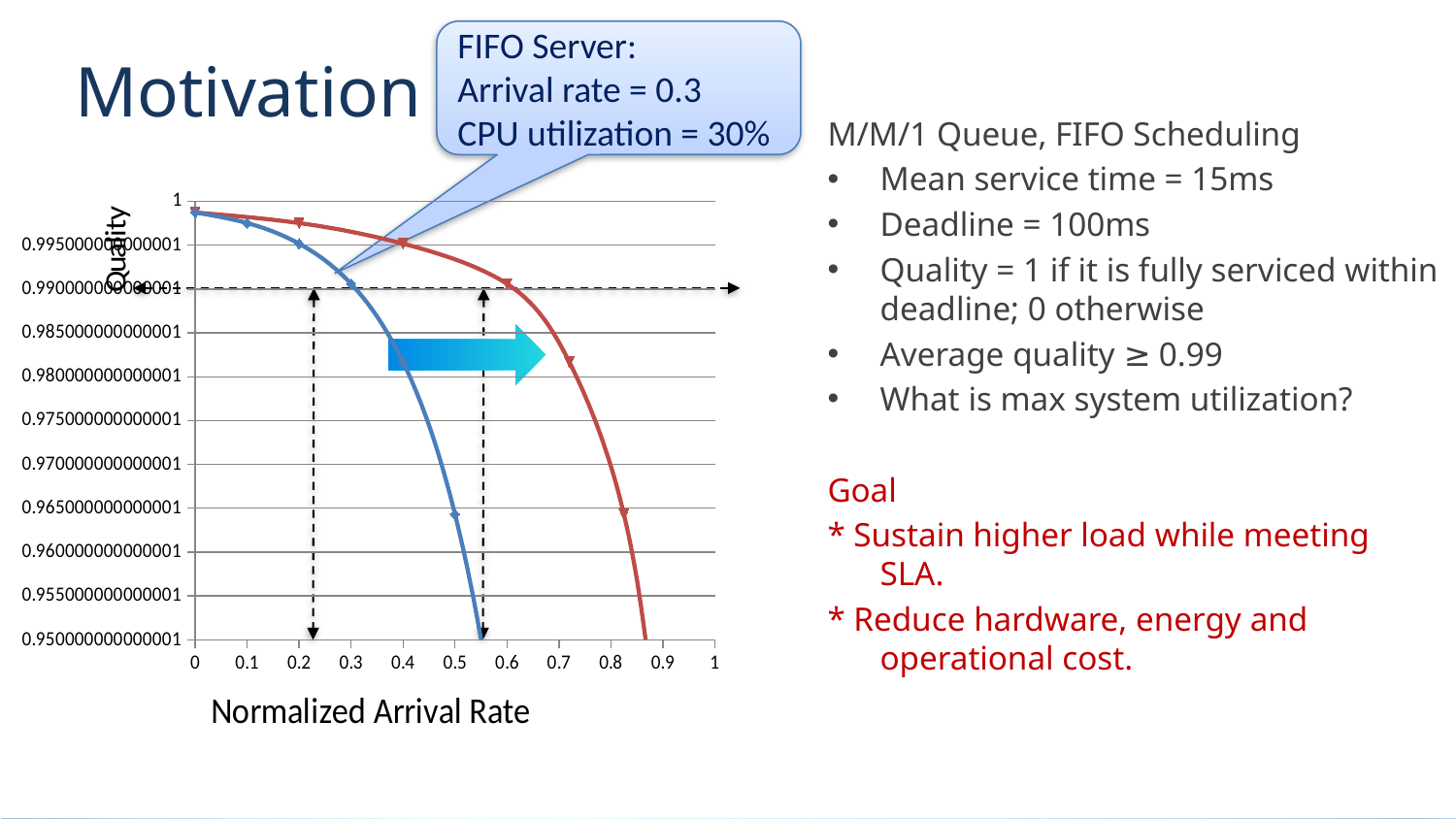
At a normalized arrival rate of 0.5, which curve has the higher quality, the blue one or the red one? The red one Is the quality of the red curve at a normalized arrival rate of 0.4 greater or less than 0.99? greater Is the quality of the blue curve at a normalized arrival rate of 0.5 greater or less than 0.97? less How many curves are plotted on the chart? 2 What is the label of the y axis of the chart? Quality Which curve reaches the bottom of the chart (quality 0.95) at the lower normalized arrival rate, the blue one or the red one? The blue one What is the label of the x axis of the chart? Normalized Arrival Rate Do the plotted quality values rise or fall as the normalized arrival rate increases? Fall What is the highest value shown on the x axis of the chart? 1 Is the quality of the blue curve at a normalized arrival rate of 0.2 greater or less than 0.99? greater What kind of chart is shown on the slide? Line chart